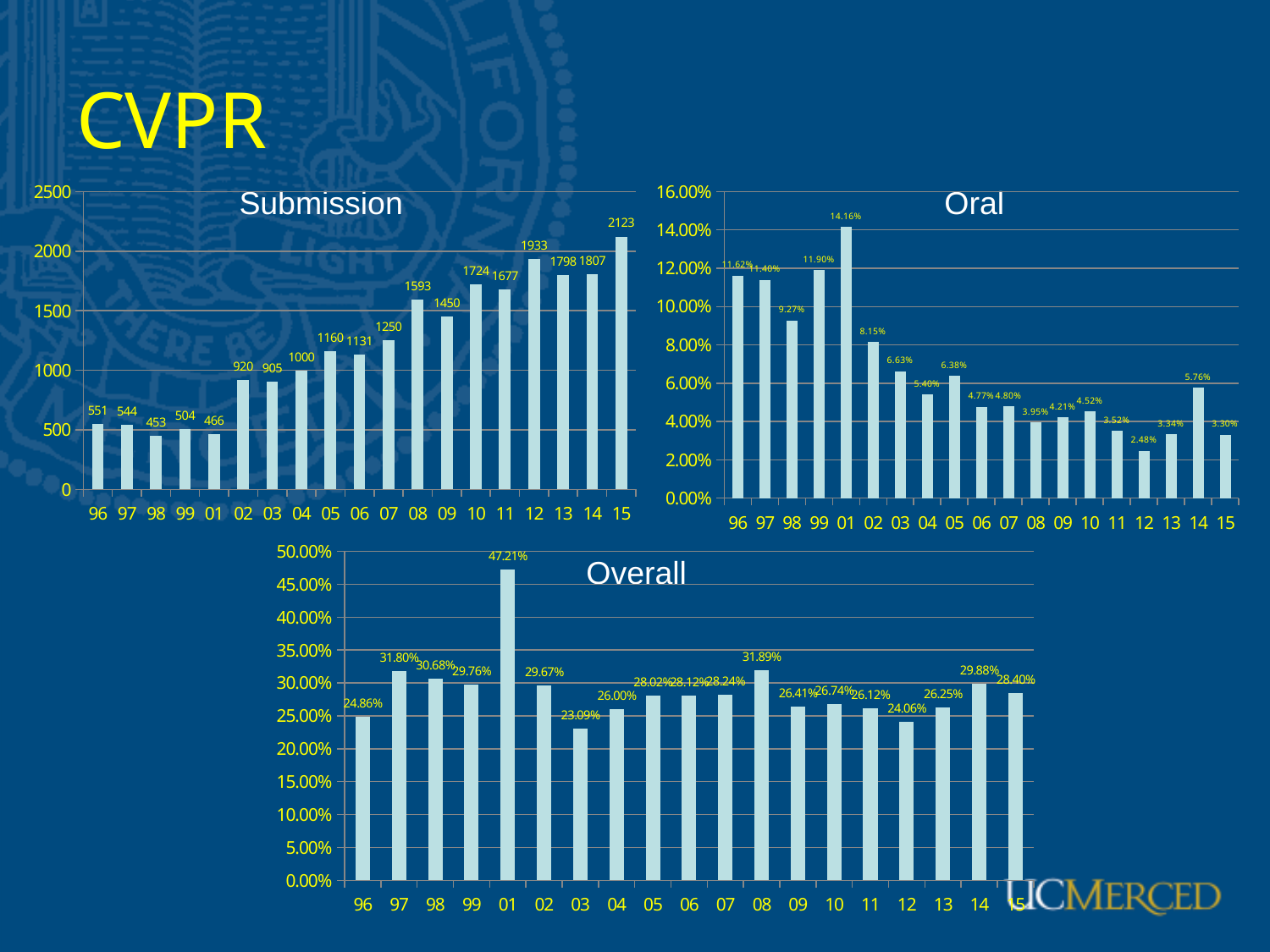
In the Submission chart, which is larger, the value for 12 or the value for 13? 12 In the Overall chart, which year has the highest value? 01 In the Submission chart, what is the value for 15? 2123 In the Overall chart, what is the difference between the values for 01 and 03? 24.12% In the Oral chart, do the values generally rise or fall from 96 to 15? fall In the Oral chart, which year has the lowest value? 12 How many years are shown on the x axis of the Submission chart? 19 In the Submission chart, what is the difference between the values for 15 and 96? 1572 In the Submission chart, which year has the lowest value? 98 In the Oral chart, what is the value for 01? 14.16% In the Oral chart, which is larger, the value for 05 or the value for 14? 05 What kind of chart is the Overall chart? bar chart